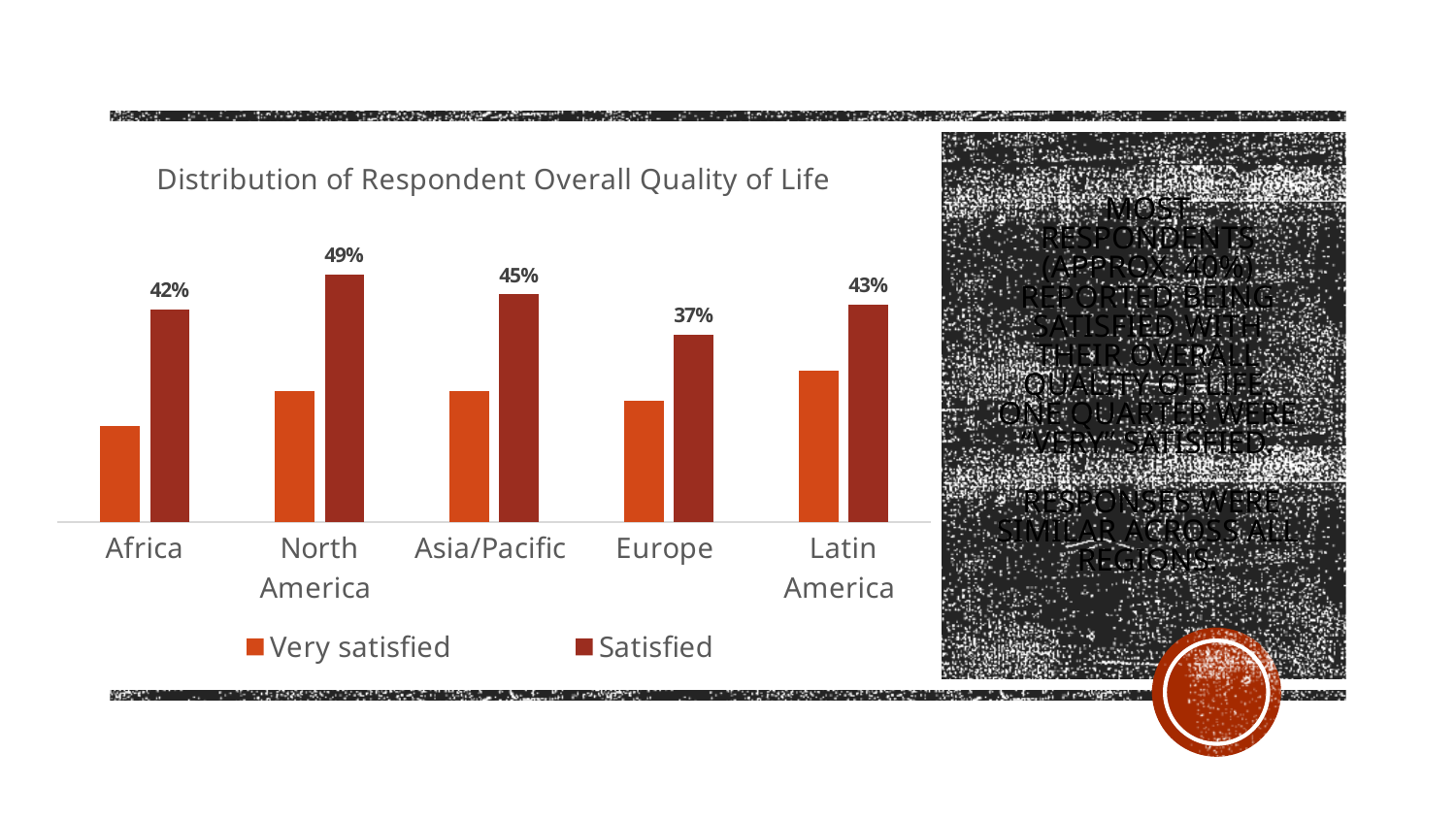
How many regions are shown on the x axis? 5 Which is larger for Asia/Pacific, the Very satisfied bar or the Satisfied bar? Satisfied What is the Satisfied value for Europe? 37% What is the difference between the Satisfied values for North America and Europe? 12% Which region has the taller Very satisfied bar, Africa or Latin America? Latin America Which region has the highest Satisfied value? North America How many series does the legend list? 2 What is the Satisfied value for North America? 49% What is the Satisfied value for Latin America? 43% Which region has the lowest Satisfied value? Europe What kind of chart is shown on the slide? Bar chart What is the Satisfied value for Africa? 42%